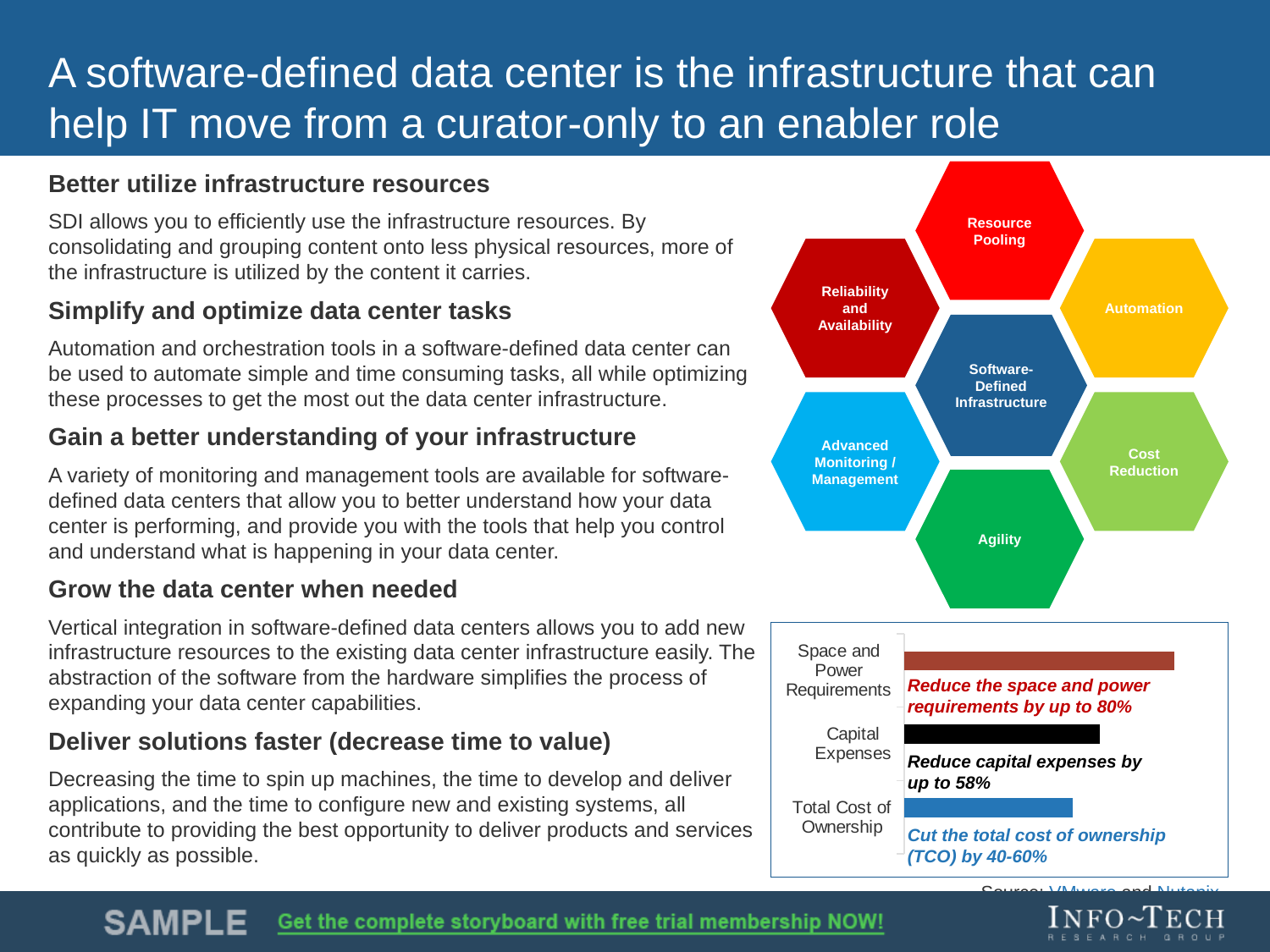
What is the difference in percentage points between the maximum reduction in space and power requirements (80%) and the maximum reduction in capital expenses (58%) shown in the bar chart? 22 percentage points What colour is the bar for Capital Expenses in the bar chart? Black What kind of chart is shown at the bottom right of the slide? Bar chart How many categories does the bar chart at the bottom right of the slide show? 3 In the bar chart, is the bar for Space and Power Requirements longer or shorter than the bar for Capital Expenses? Longer In the bar chart, is the bar for Capital Expenses longer or shorter than the bar for Total Cost of Ownership? Longer According to the bar chart, by up to what percentage can capital expenses be reduced? 58% In the bar chart, which category has the longest bar? Space and Power Requirements According to the bar chart, by what range can the total cost of ownership (TCO) be cut? 40-60% In the bar chart, which category has the shortest bar? Total Cost of Ownership According to the bar chart, by up to what percentage can space and power requirements be reduced? 80% What colour is the bar for Total Cost of Ownership in the bar chart? Blue